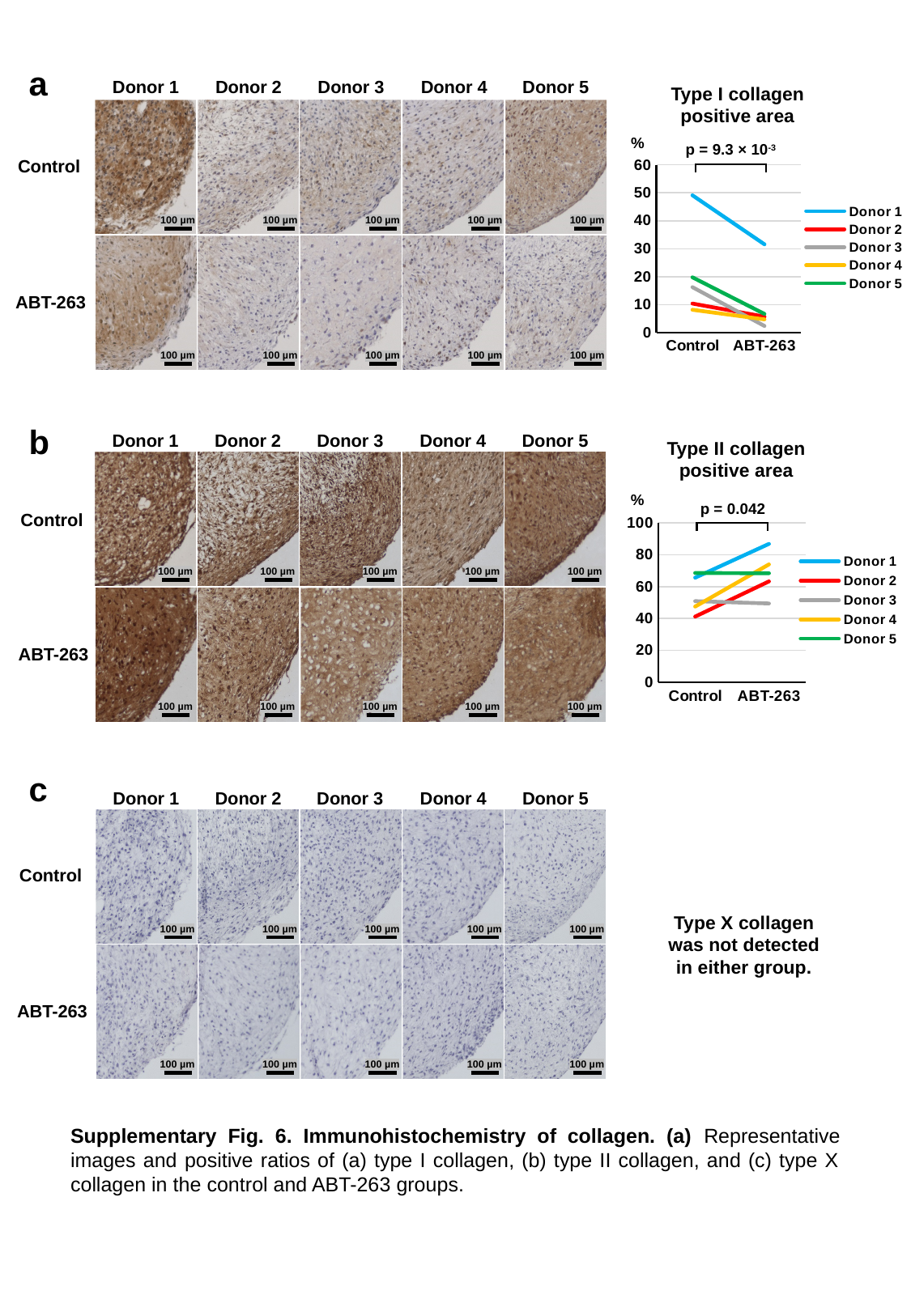
How many categories are shown on the x axis of the "Type I collagen positive area" chart? 2 In the "Type I collagen positive area" chart, which donor has the highest Control value? Donor 1 In the "Type II collagen positive area" chart, is the ABT-263 value for Donor 1 greater or less than 80? greater What kind of chart is the "Type I collagen positive area" chart? Line chart In the "Type I collagen positive area" chart, is the ABT-263 value for Donor 1 greater or less than 20? greater In the "Type II collagen positive area" chart, does the value for Donor 2 rise or fall from Control to ABT-263? Rise In the "Type II collagen positive area" chart, which donor has the highest ABT-263 value? Donor 1 In the "Type I collagen positive area" chart, is the Control value for Donor 1 greater or less than 40? greater In the "Type I collagen positive area" chart, does the value for Donor 1 rise or fall from Control to ABT-263? Fall How many series does the legend of the "Type I collagen positive area" chart list? 5 What p-value is printed on the "Type II collagen positive area" chart? p = 0.042 In the "Type II collagen positive area" chart, which donor has the lowest Control value? Donor 2